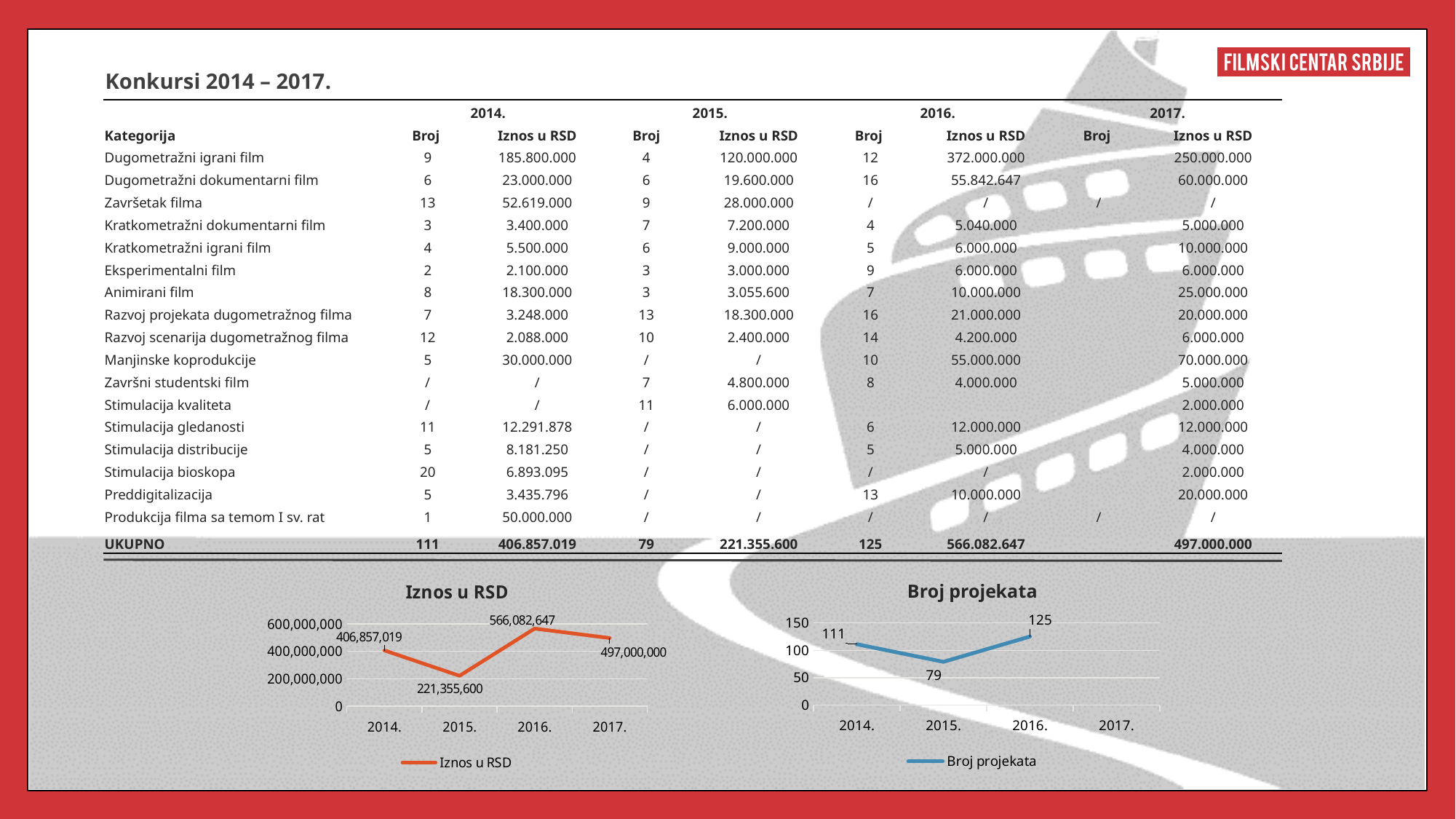
In the 'Broj projekata' chart, which year has the lowest value? 2015. In the 'Broj projekata' chart, what is the value for 2014.? 111 What type of chart is the 'Iznos u RSD' chart? line chart In the 'Iznos u RSD' chart, what is the difference between the 2016. and 2017. values? 69,082,647 In the 'Iznos u RSD' chart, what is the value for 2015.? 221,355,600 In the 'Broj projekata' chart, is the value for 2016. larger or smaller than the value for 2014.? larger In the 'Iznos u RSD' chart, which year has the lowest value? 2015. In the 'Iznos u RSD' chart, is the value for 2014. greater or less than 400,000,000? greater In the 'Iznos u RSD' chart, what is the value for 2016.? 566,082,647 In the 'Iznos u RSD' chart, which year has the highest value? 2016. In the 'Broj projekata' chart, how many series does the legend list? 1 In the 'Broj projekata' chart, what is the difference between the 2016. and 2015. values? 46